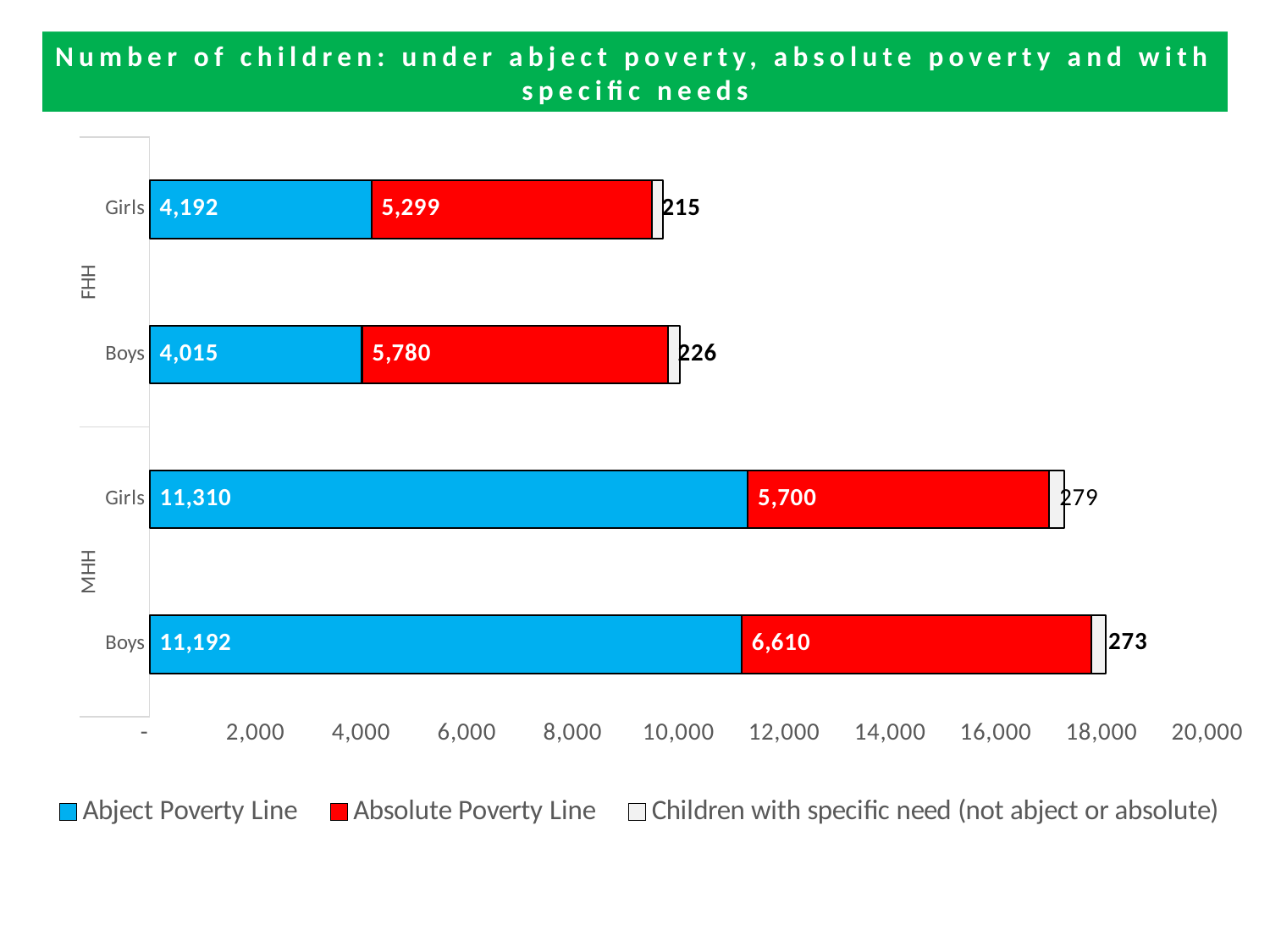
What is the total of the stacked bar for MHH Boys? 18,075 What is the Abject Poverty Line value for MHH Girls? 11,310 What is the difference between the Abject Poverty Line values for MHH Girls and MHH Boys? 118 What is the value for Children with specific need (not abject or absolute) for MHH Boys? 273 Which category has the highest Absolute Poverty Line value? MHH Boys Which is larger: the Absolute Poverty Line value for FHH Girls or for MHH Girls? MHH Girls How many series does the legend list? 3 What kind of chart is shown on the slide? Stacked bar chart How many categories (bars) are shown in the chart? 4 Which category has the lowest Abject Poverty Line value? FHH Boys What is the Absolute Poverty Line value for FHH Boys? 5,780 What is the total of the stacked bar for FHH Girls? 9,706